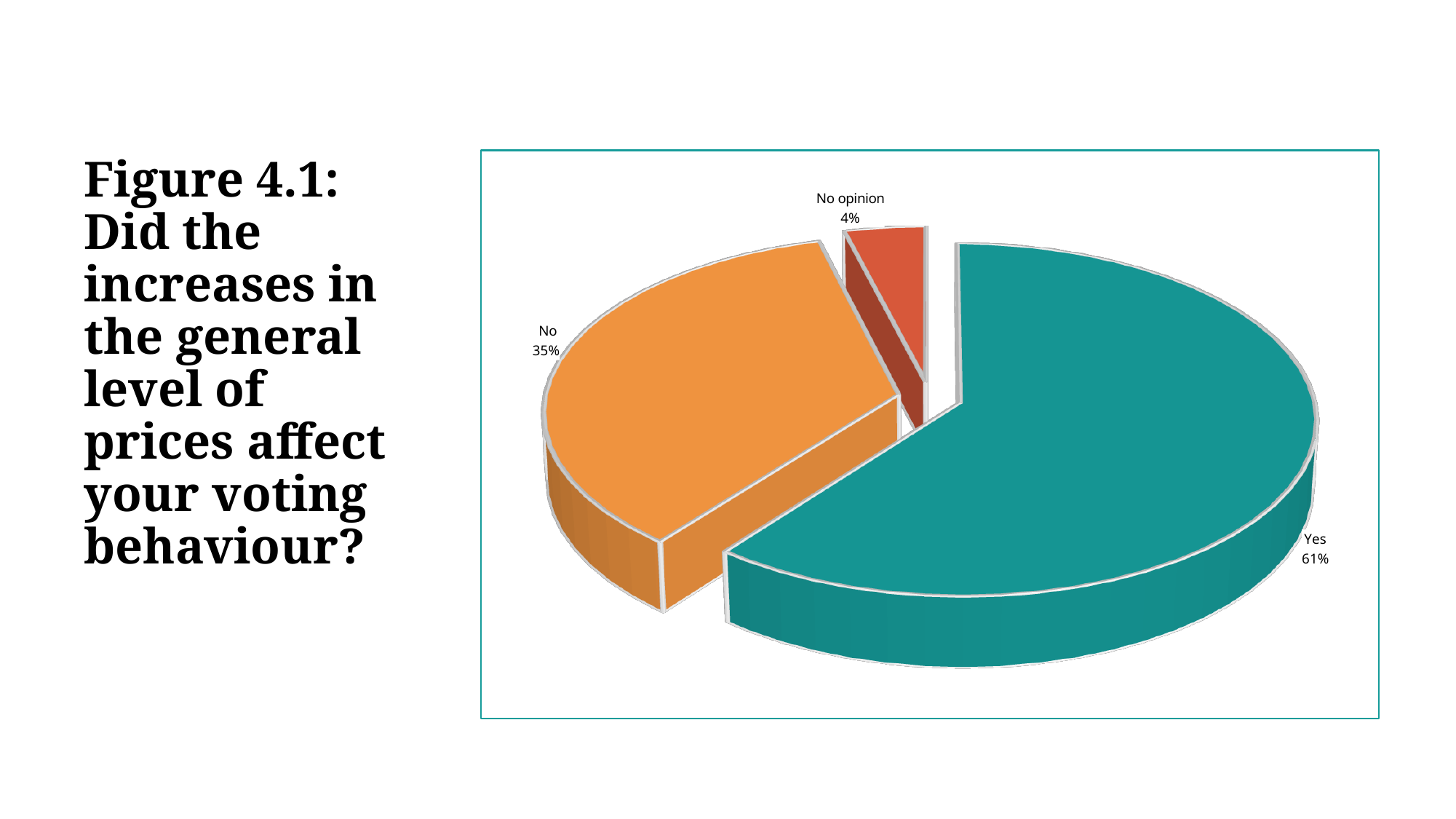
What share of respondents answered No? 35% What share of respondents answered Yes? 61% Which response has the smallest slice of the pie? No opinion What colour is the Yes slice? Teal Which is larger, the No slice or the No opinion slice? No Which response has the largest slice of the pie? Yes What kind of chart is shown on the slide? Pie chart How many slices does the pie chart have? 3 What is the figure number given in the slide title? Figure 4.1 What is the combined share of the No and No opinion slices? 39% What is the difference in percentage points between the Yes and No slices? 26 What share of respondents had No opinion? 4%